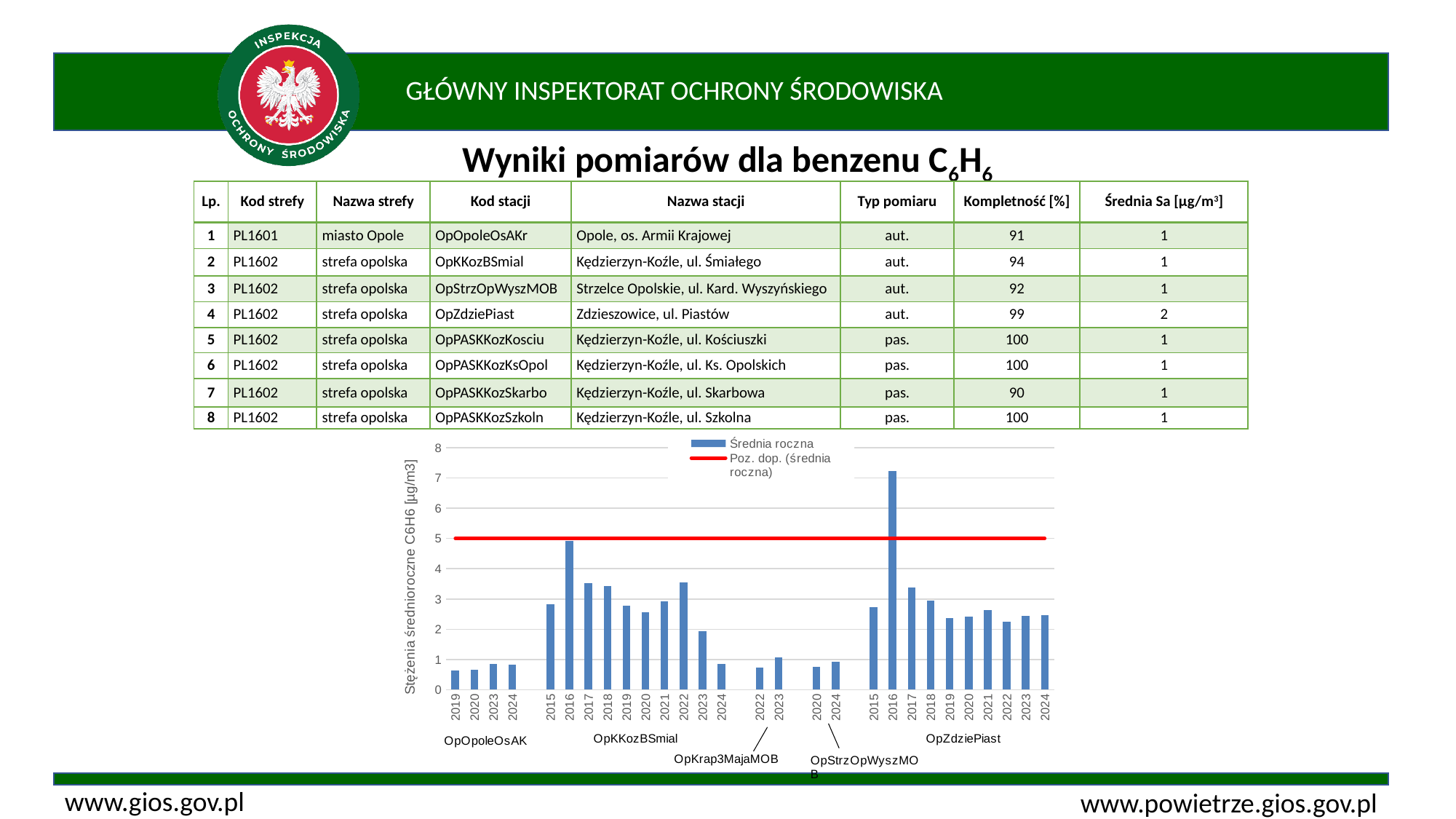
Is the value for OpOpoleOsAK in 2019 greater or less than 1? less For OpZdziePiast, do the values rise or fall from 2016 to 2019? fall Which station and year has the highest bar in the chart? OpZdziePiast, 2016 Is the value for OpZdziePiast in 2016 greater or less than 7? greater How many series does the chart legend list? 2 What kind of chart is shown below the table? combination bar and line chart Which is larger, the 2016 bar for OpKKozBSmial or the 2016 bar for OpZdziePiast? OpZdziePiast 2016 How many bars are plotted for the station OpZdziePiast? 10 At what value on the y axis does the red 'Poz. dop. (średnia roczna)' line lie? 5 What are the two entries in the chart legend? Średnia roczna; Poz. dop. (średnia roczna) How many bars are plotted for the station OpOpoleOsAK? 4